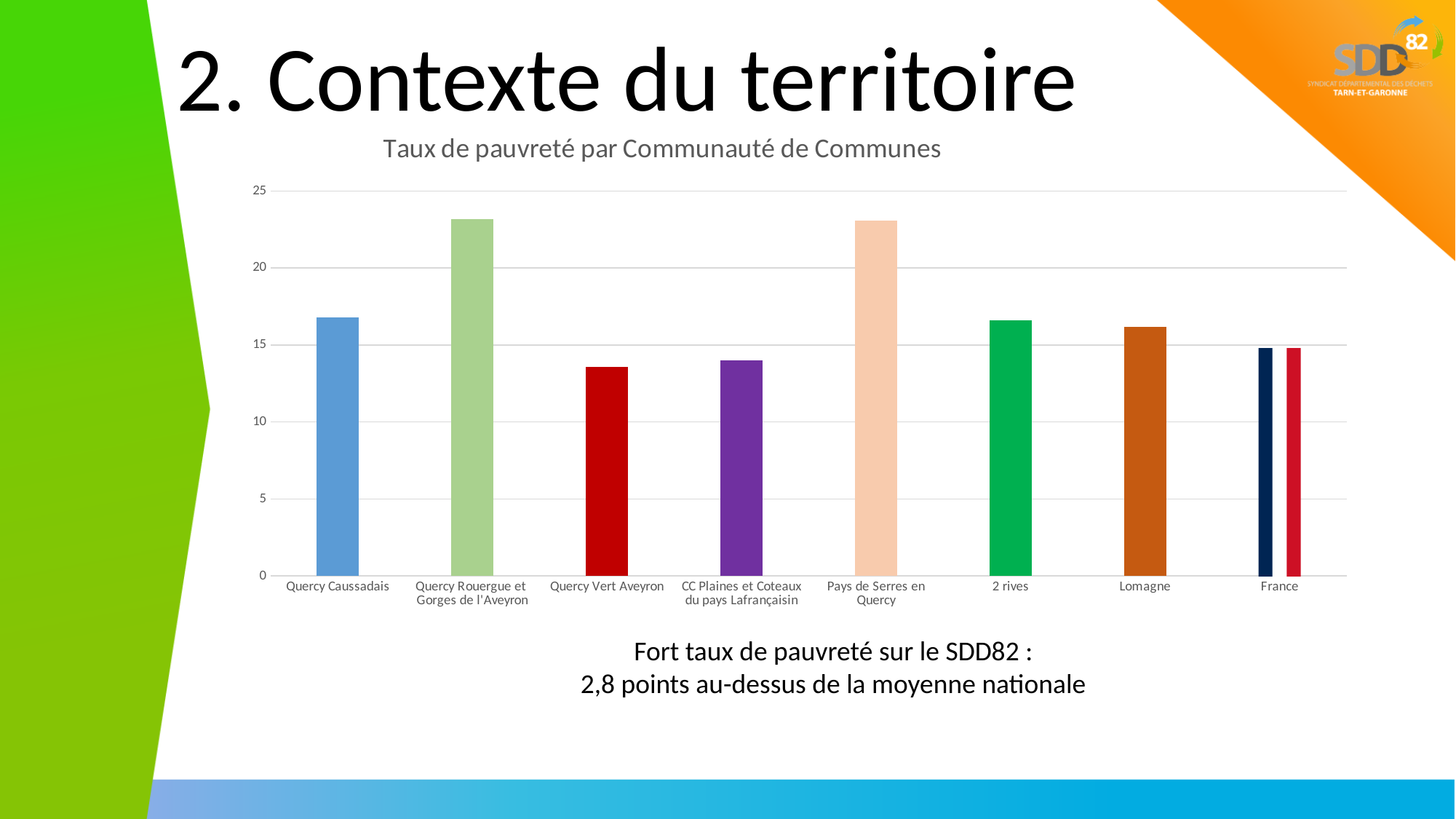
Is the value for Quercy Rouergue et Gorges de l'Aveyron greater or less than 20? greater Is the value for Lomagne greater or less than 15? greater What kind of chart is shown on the slide? Bar chart Which has the higher value, Pays de Serres en Quercy or Lomagne? Pays de Serres en Quercy What is the title of the chart? Taux de pauvreté par Communauté de Communes How many categories are shown on the x axis of the chart? 8 Is the value for Pays de Serres en Quercy greater or less than 20? greater Which has the higher value, 2 rives or France? 2 rives Which has the higher value, Quercy Rouergue et Gorges de l'Aveyron or Quercy Vert Aveyron? Quercy Rouergue et Gorges de l'Aveyron